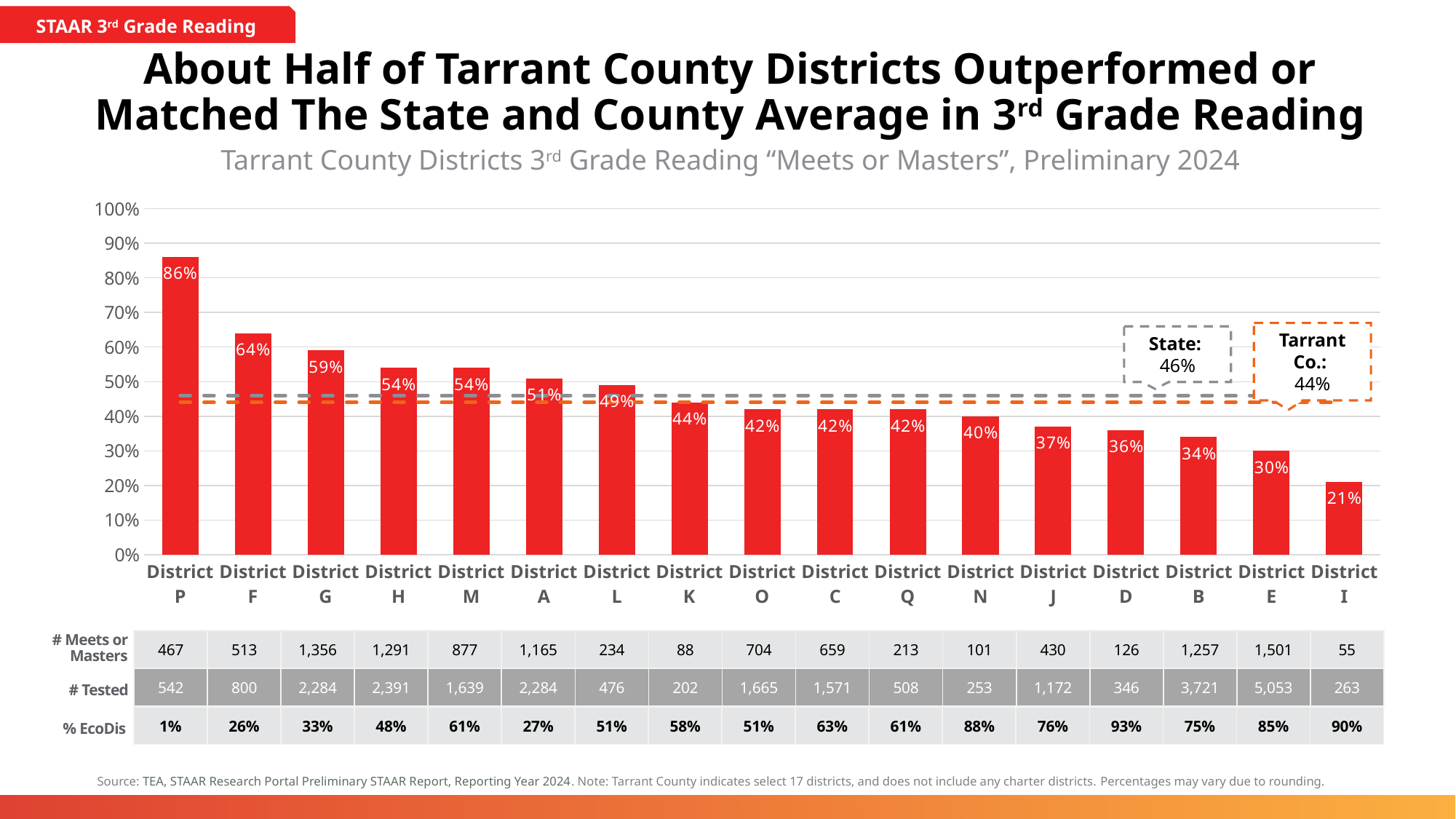
What is the difference between the values for District P and District F? 22% What value does the dashed State reference line represent? 46% Which district has the lowest value? District I What is the value for District L? 49% What is the difference between the values for District G and District I? 38% What is the value for District E? 30% What is the value for District P? 86% What kind of chart is shown on the slide? Bar chart How many districts are plotted in the chart? 17 Do the values rise or fall from left to right along the x axis? Fall Which district has the highest value? District P Which is larger, the value for District N or the value for District J? District N